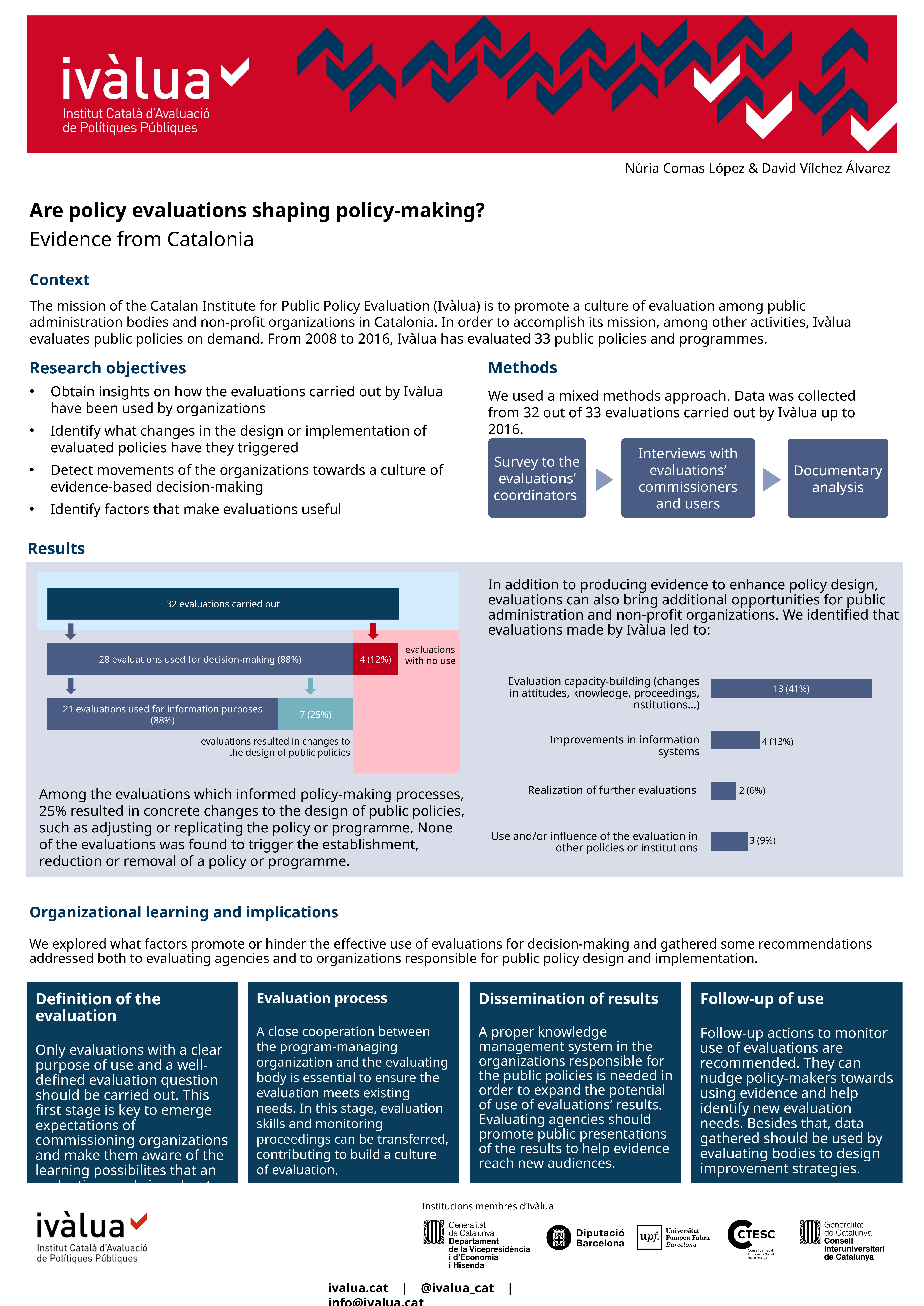
In the bar chart on the right of the Results section, which is larger: 'Improvements in information systems' or 'Use and/or influence of the evaluation in other policies or institutions'? Improvements in information systems In the flow diagram on the left of the Results section, how many evaluations resulted in changes to the design of public policies? 7 (25%) In the bar chart on the right of the Results section, what is the value for 'Improvements in information systems'? 4 (13%) In the flow diagram on the left of the Results section, how many evaluations were used for decision-making? 28 (88%) How many categories does the bar chart on the right of the Results section show? 4 What kind of chart is shown on the right of the Results section? Bar chart In the bar chart on the right of the Results section, what is the value for 'Evaluation capacity-building'? 13 (41%) In the bar chart on the right of the Results section, how many more evaluations led to 'Evaluation capacity-building' than to 'Improvements in information systems'? 9 In the bar chart on the right of the Results section, what is the value for 'Use and/or influence of the evaluation in other policies or institutions'? 3 (9%) In the bar chart on the right of the Results section, what is the value for 'Realization of further evaluations'? 2 (6%) In the bar chart on the right of the Results section, which category has the highest value? Evaluation capacity-building In the bar chart on the right of the Results section, which category has the lowest value? Realization of further evaluations